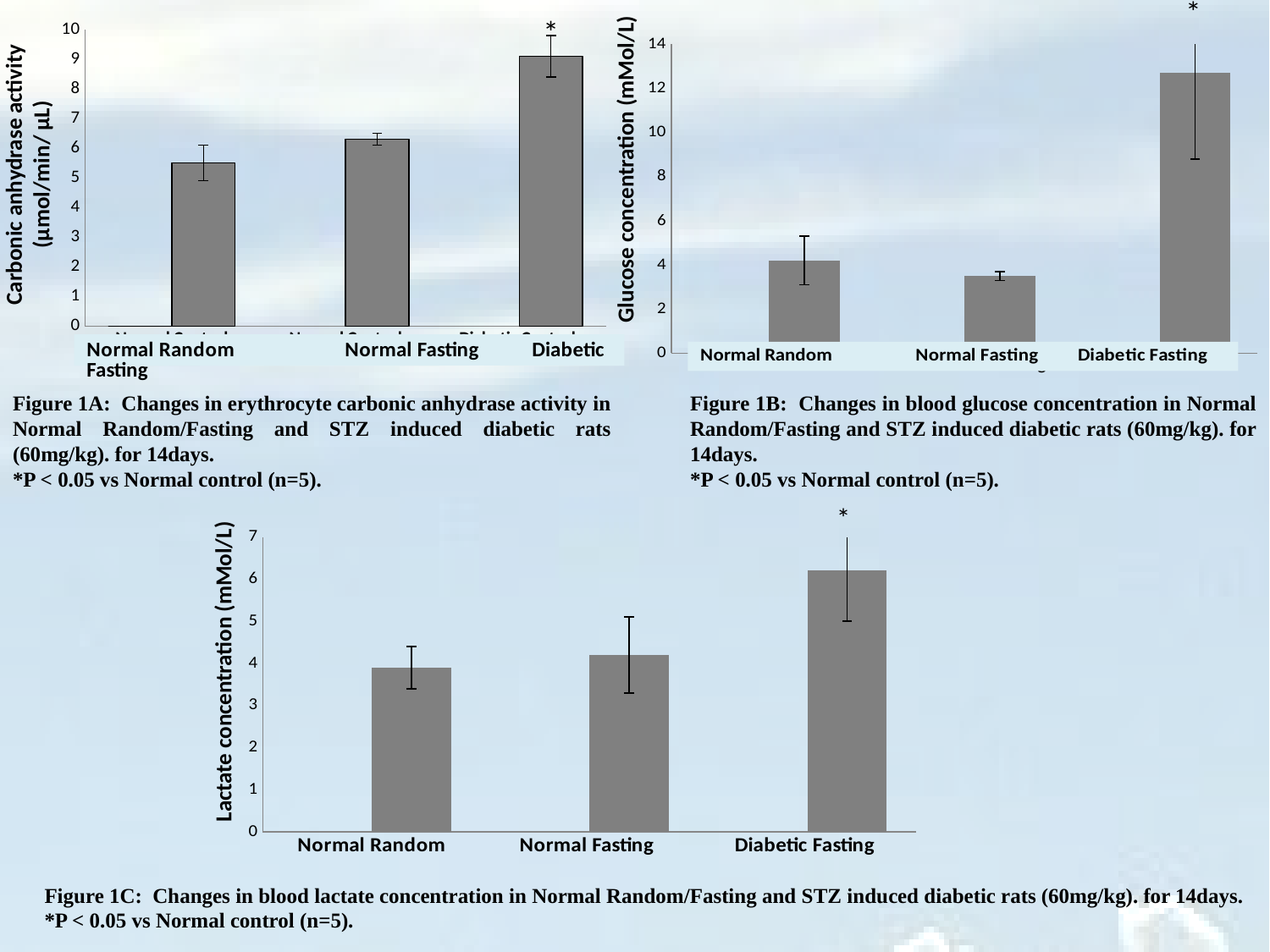
In Figure 1B, which category has the lowest glucose concentration? Normal Fasting What is the y-axis label of Figure 1C? Lactate concentration (mMol/L) In Figure 1C, which category has the highest lactate concentration? Diabetic Fasting In Figure 1B, which is larger, the value for Normal Random or the value for Normal Fasting? Normal Random What kind of chart is Figure 1B? bar chart In Figure 1A, is the value for Normal Random Fasting greater or less than 6? less In Figure 1C, is the value for Diabetic Fasting greater or less than 6? greater In Figure 1B, is the value for Diabetic Fasting greater or less than 12? greater How many categories are plotted in Figure 1C? 3 In Figure 1A, which category has the highest carbonic anhydrase activity? Diabetic